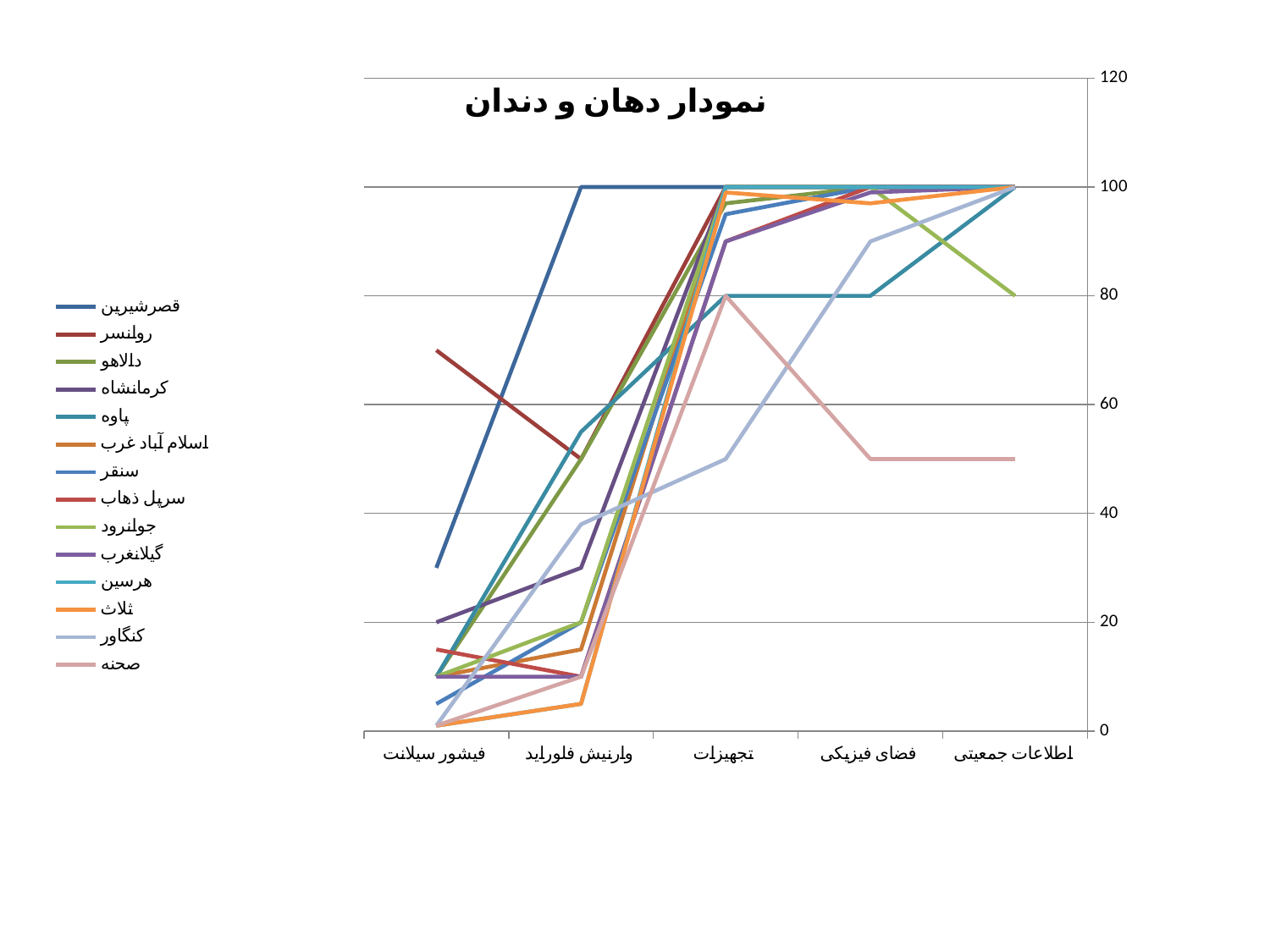
Which series has the lowest value at اطلاعات جمعیتی? صحنه Is the value for قصرشیرین at وارنیش فلوراید greater or less than 80? greater What is the title of the chart? نمودار دهان و دندان How many series does the legend list? 14 At فیشور سیلانت, which is larger: روانسر or قصرشیرین? روانسر Which series has the highest value at فیشور سیلانت? روانسر What is the value for قصرشیرین at اطلاعات جمعیتی? 100 What kind of chart is shown on the slide? line chart How many categories are shown on the x axis? 5 Is the value for روانسر at فیشور سیلانت greater or less than 60? greater Does the value for صحنه rise or fall from تجهیزات to فضای فیزیکی? fall Is the value for صحنه at اطلاعات جمعیتی greater or less than 60? less